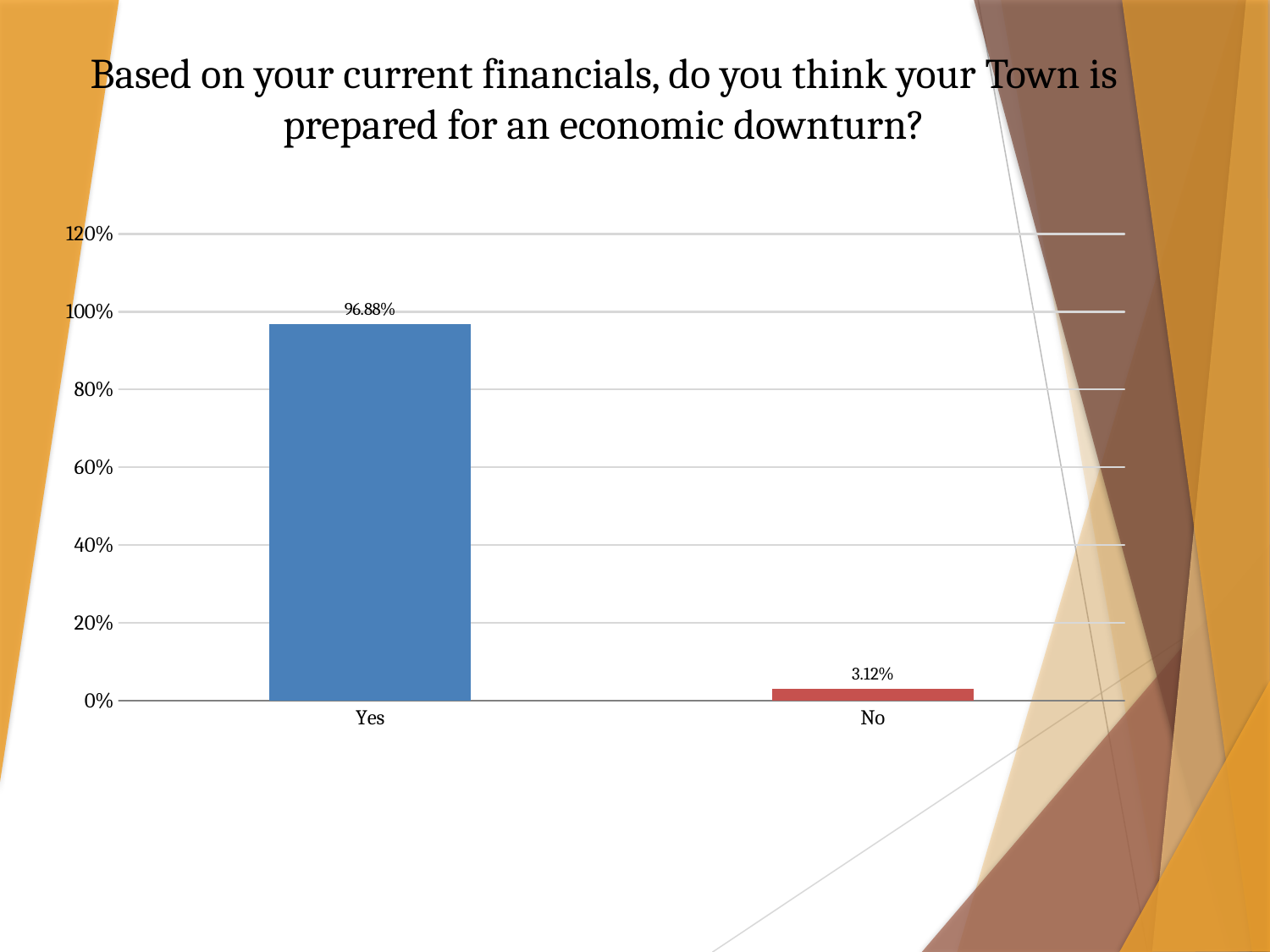
Is the value for No greater or less than 20%? less What kind of chart is shown on the slide? bar chart What colour is the bar for No? red What is the highest value shown on the y axis? 120% Is the value for Yes greater or less than 80%? greater Which category has the highest value? Yes What is the value for No? 3.12% Which is larger, the value for Yes or the value for No? Yes What is the value for Yes? 96.88% How many categories are shown on the x axis? 2 Which category has the lowest value? No What is the difference between the values for Yes and No? 93.76%